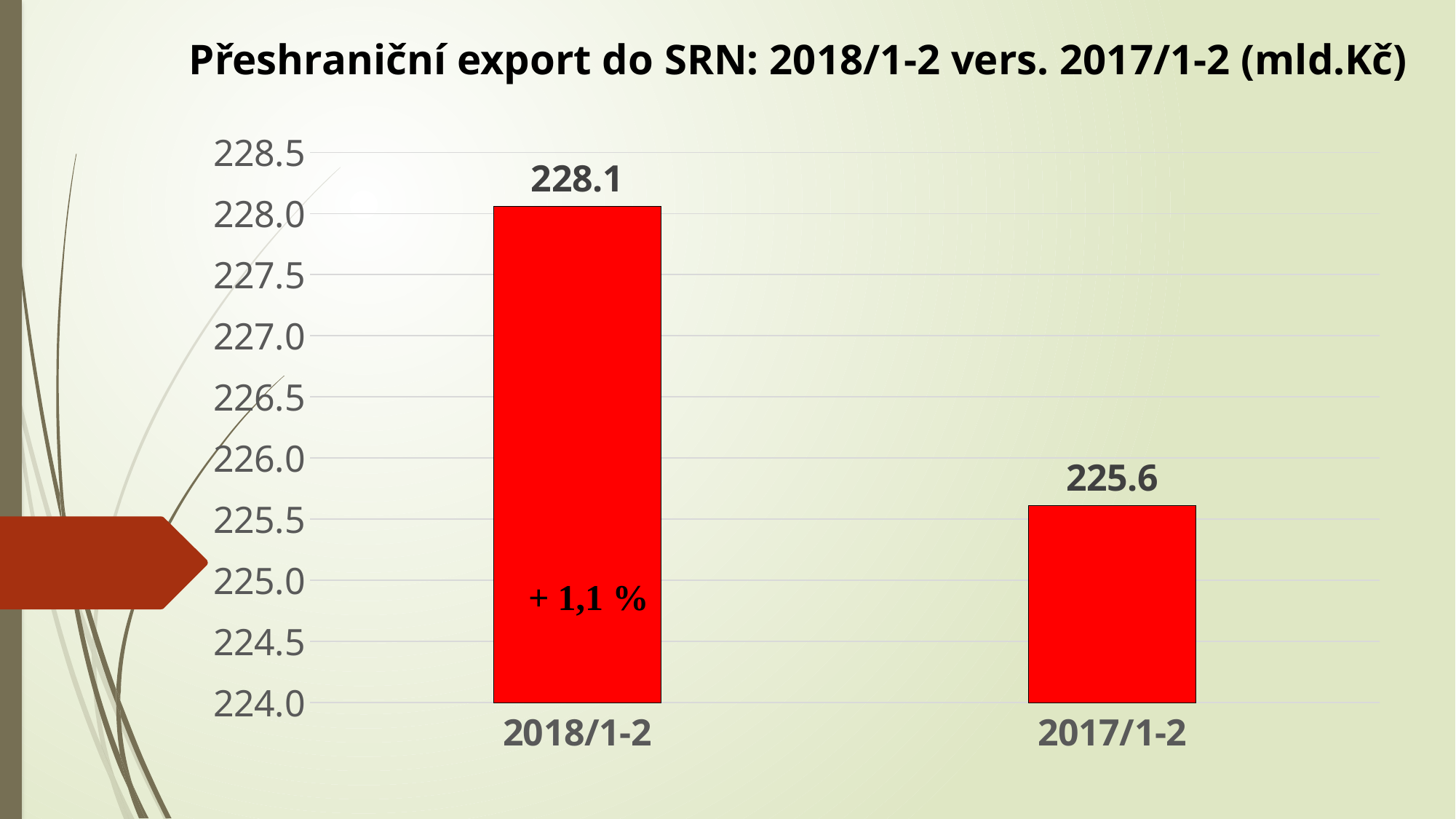
What is the value for 2017/1-2? 225.6 What percentage change is printed inside the 2018/1-2 bar? + 1,1 % Which is larger, the value for 2018/1-2 or the value for 2017/1-2? 2018/1-2 What kind of chart is shown on the slide? bar chart Is the value for 2017/1-2 greater or less than 226.0? less What is the title of the chart? Přeshraniční export do SRN: 2018/1-2 vers. 2017/1-2 (mld.Kč) How many categories are shown on the chart? 2 Is the value for 2018/1-2 greater or less than 227.0? greater Which category has the lowest value? 2017/1-2 What is the value for 2018/1-2? 228.1 Which category has the highest value? 2018/1-2 What is the difference between the values for 2018/1-2 and 2017/1-2? 2.5